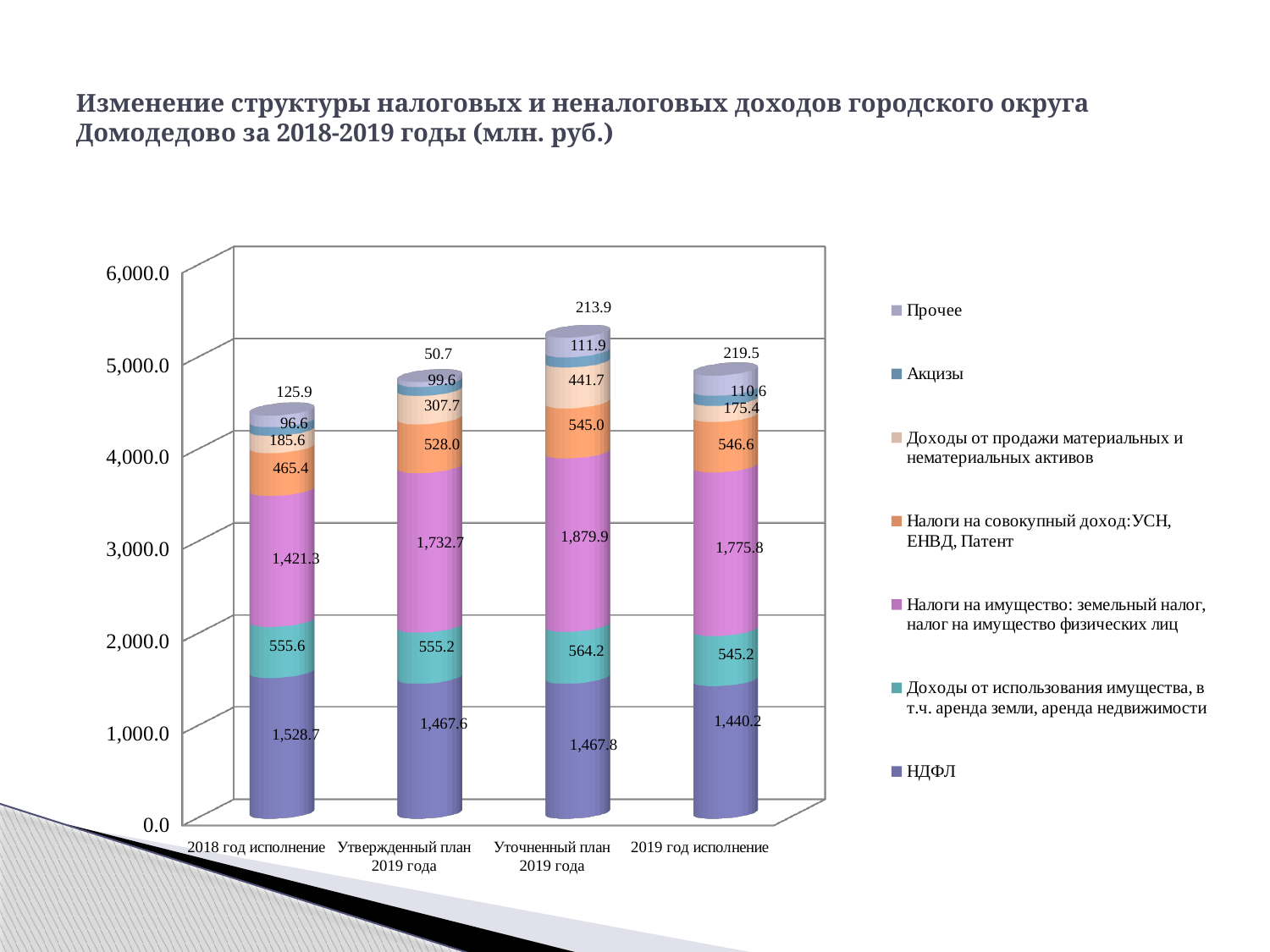
How many categories are shown along the x axis? 4 What is the value of Налоги на имущество for Уточненный план 2019 года? 1,879.9 What type of chart is shown on the slide? Stacked bar chart Which category has the highest value for Доходы от продажи материальных и нематериальных активов? Уточненный план 2019 года What is the value of Прочее for Утвержденный план 2019 года? 50.7 What is the value of НДФЛ for 2018 год исполнение? 1,528.7 How many series does the legend list? 7 Which category has the lowest value for Прочее? Утвержденный план 2019 года Which is larger: Налоги на совокупный доход for 2019 год исполнение or for Уточненный план 2019 года? 2019 год исполнение What is the difference between Налоги на имущество for 2019 год исполнение and for 2018 год исполнение? 354.5 What is the total of the stacked bar for 2018 год исполнение? 4,379.1 What is the value of Акцизы for 2019 год исполнение? 110.6